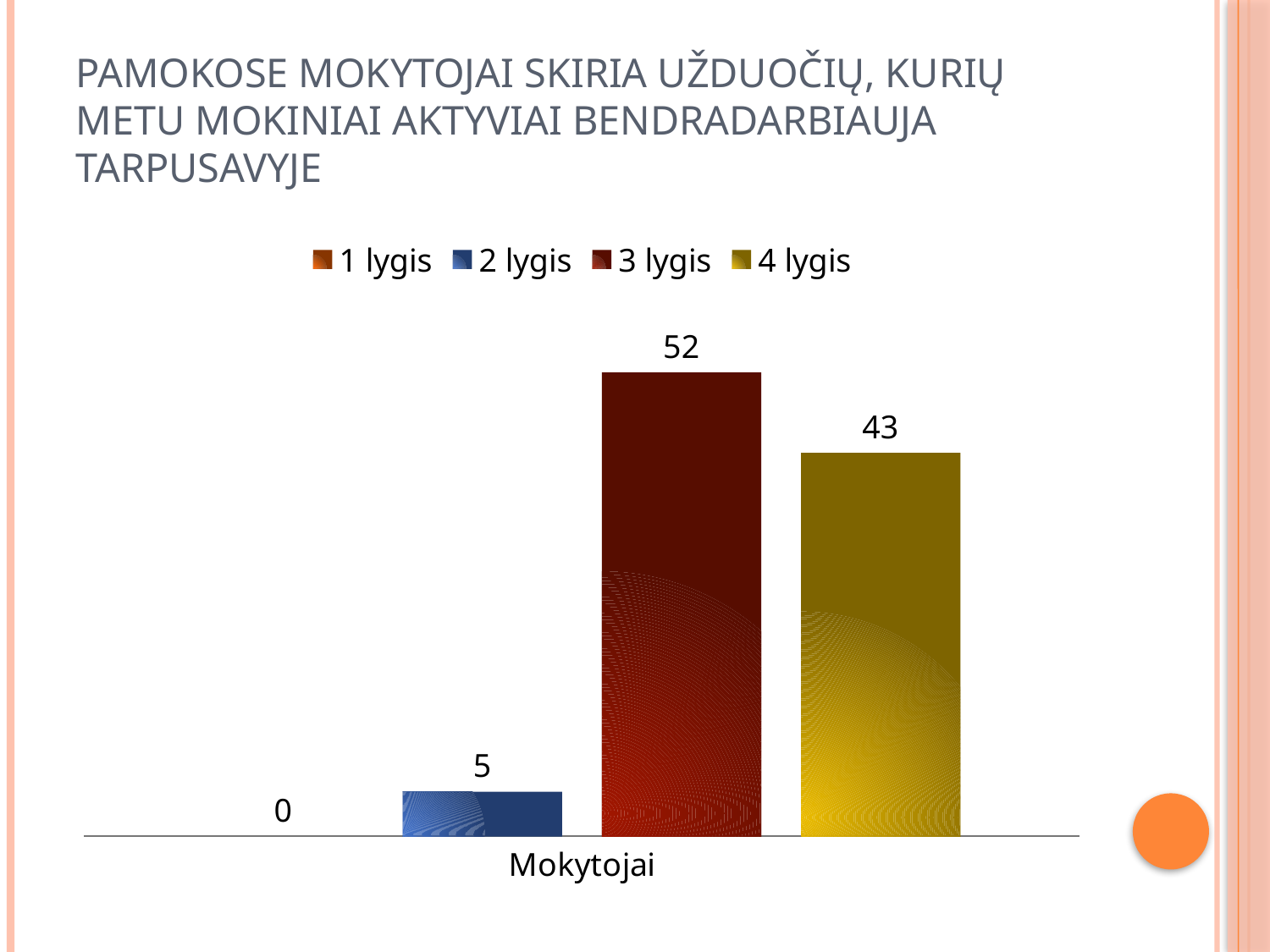
What kind of chart is shown on the slide? bar chart What is the value for 2 lygis? 5 What is the value for 1 lygis? 0 What is the difference between the values for 3 lygis and 4 lygis? 9 Which series has the highest value? 3 lygis What is the total of the values for 2 lygis, 3 lygis and 4 lygis? 100 What is the value for 3 lygis? 52 Which series has the lowest value? 1 lygis How many series does the legend list? 4 What is the category label shown on the x axis? Mokytojai Which is larger, the value for 2 lygis or the value for 4 lygis? 4 lygis What is the value for 4 lygis? 43